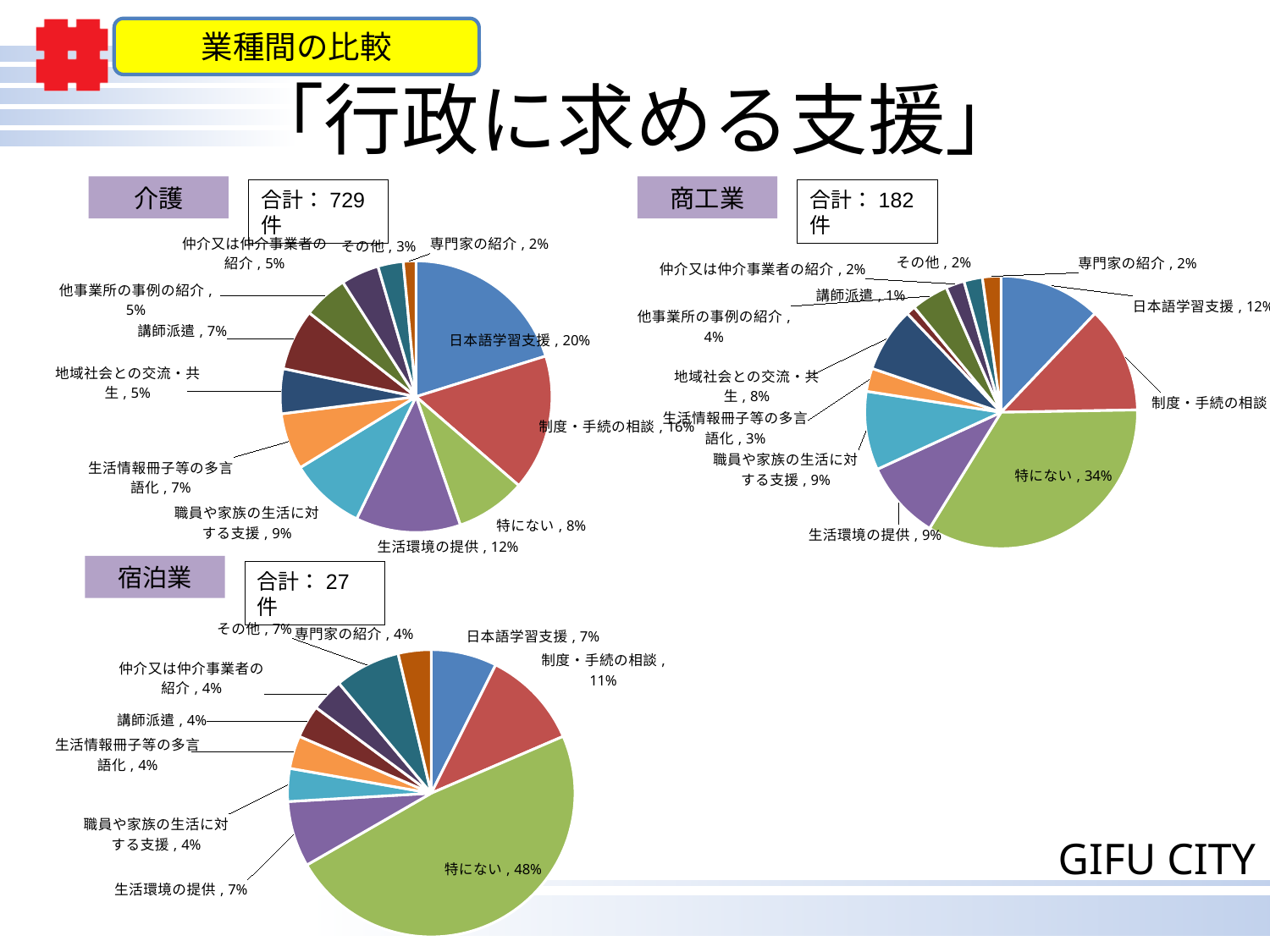
How many categories does the 宿泊業 pie chart show? 10 In the 商工業 pie chart, which is larger: 日本語学習支援 or 地域社会との交流・共生? 日本語学習支援 In the 宿泊業 pie chart, what share is labelled for 特にない? 48% In the 商工業 pie chart, which category has the smallest share? 講師派遣 In the 介護 pie chart, which category has the largest share? 日本語学習支援 In the 介護 pie chart, which category has the smallest share? 専門家の紹介 In the 商工業 pie chart, what share is labelled for 特にない? 34% In the 宿泊業 pie chart, what share is labelled for 制度・手続の相談? 11% In the 介護 pie chart, what is the difference in percentage points between 日本語学習支援 and 制度・手続の相談? 4 What total number of responses (合計) is shown for the 商工業 chart? 182件 In the 介護 pie chart, what share is labelled for 日本語学習支援? 20% What type of chart is used for the 介護 data? Pie chart